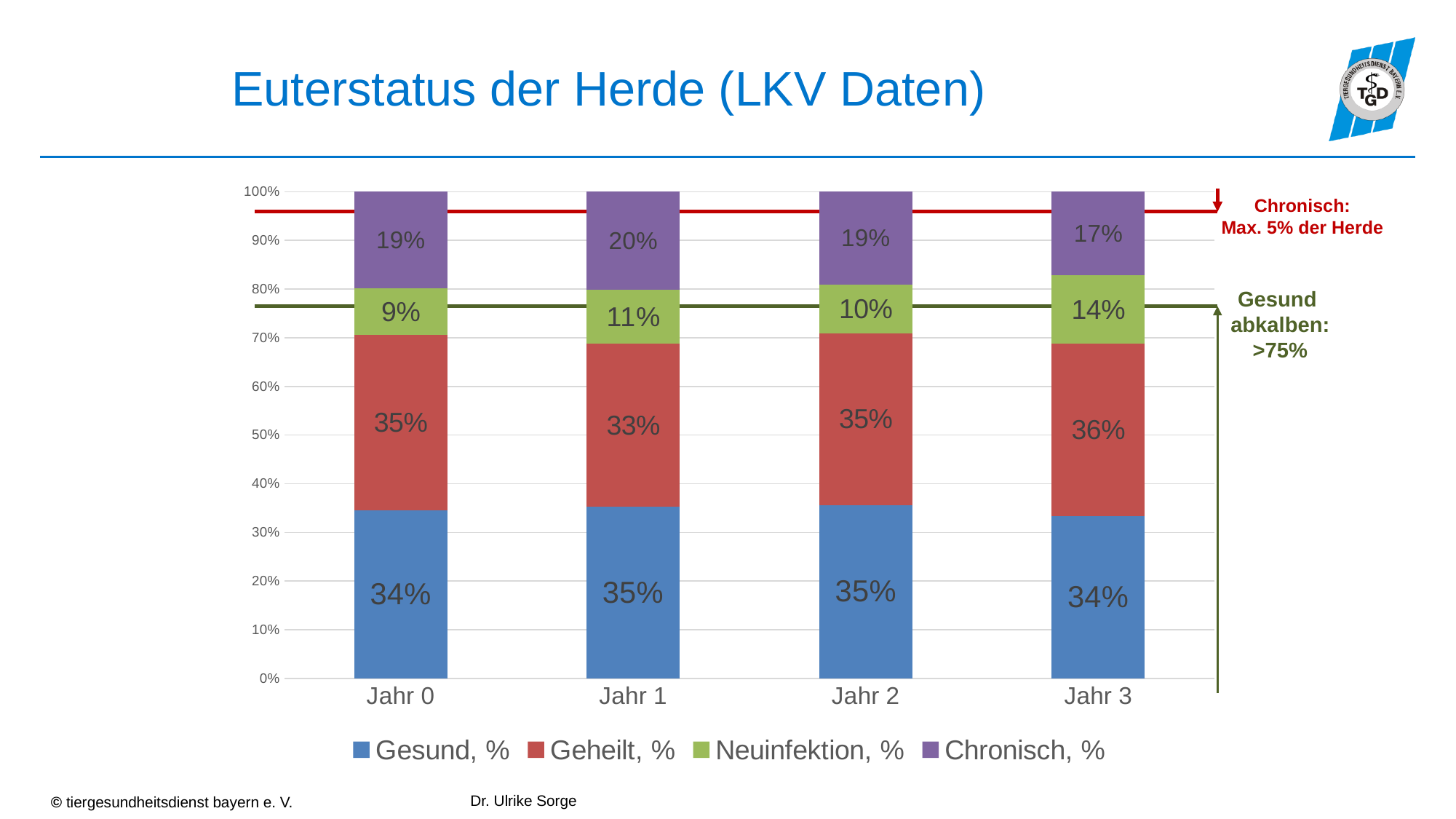
How many years (categories) are shown on the x axis? 4 What is the title of the slide? Euterstatus der Herde (LKV Daten) What is the value for Chronisch, % in Jahr 1? 20% Which is larger in Jahr 0: the Geheilt, % value or the Chronisch, % value? Geheilt, % In which year is the Chronisch, % value lowest? Jahr 3 What is the value for Geheilt, % in Jahr 2? 35% What is the value for Neuinfektion, % in Jahr 3? 14% What is the difference between the Geheilt, % values in Jahr 3 and Jahr 1? 3% What is the value for Gesund, % in Jahr 0? 34% How many series does the legend list? 4 What kind of chart is shown on the slide? Stacked bar chart In which year is the Neuinfektion, % value highest? Jahr 3